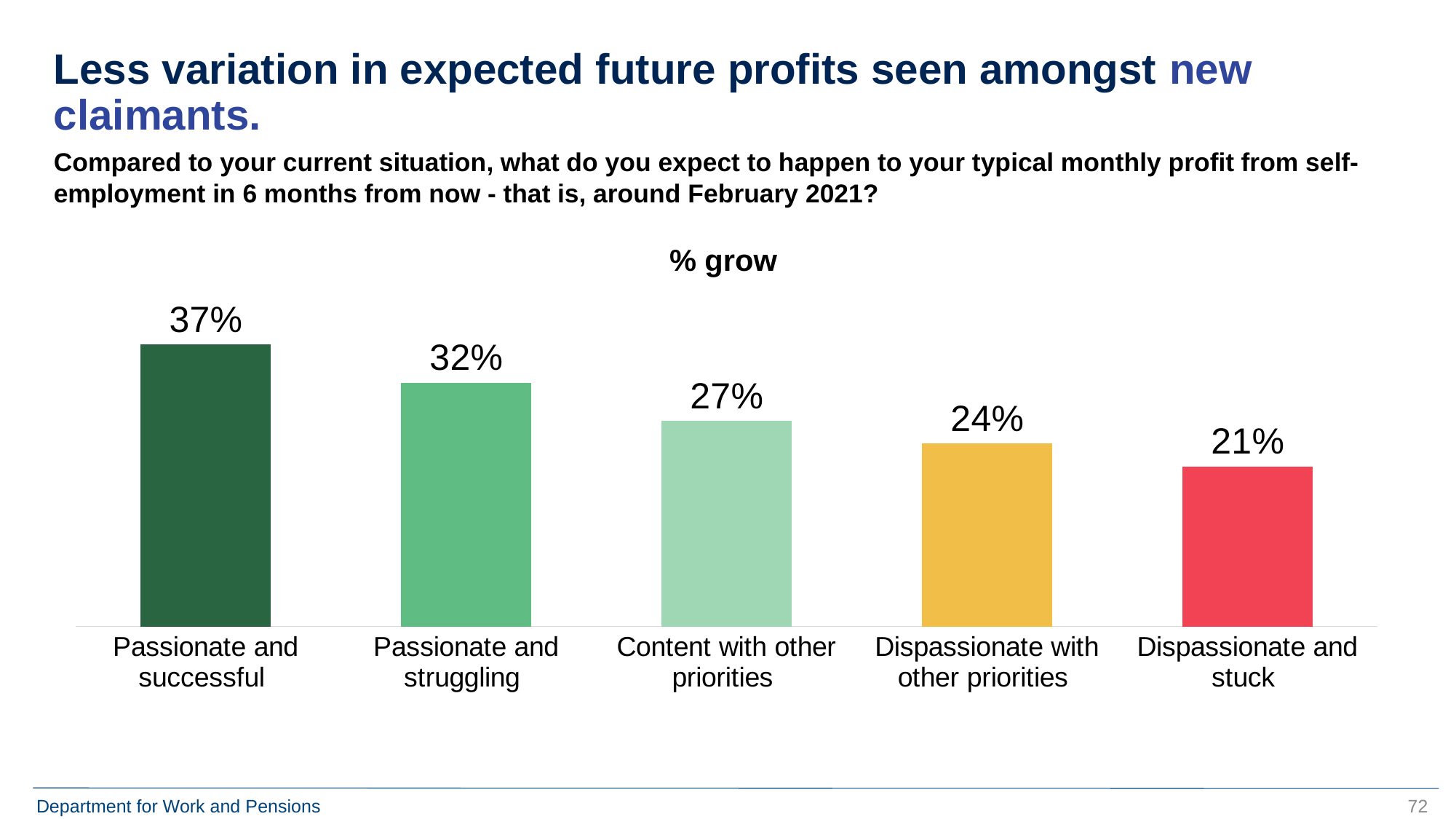
Which is larger, the value for Passionate and struggling or the value for Content with other priorities? Passionate and struggling What is the value for Passionate and struggling? 32% Do the values rise or fall from left to right along the x axis? Fall What is the value for Dispassionate with other priorities? 24% Which category has the lowest value? Dispassionate and stuck How many categories are shown in the chart? 5 What is the difference between the values for Passionate and successful and Dispassionate and stuck? 16% What is the value for Dispassionate and stuck? 21% What kind of chart is shown on the slide? Bar chart What is the value for Passionate and successful? 37% What is the value for Content with other priorities? 27% Which category has the highest value? Passionate and successful